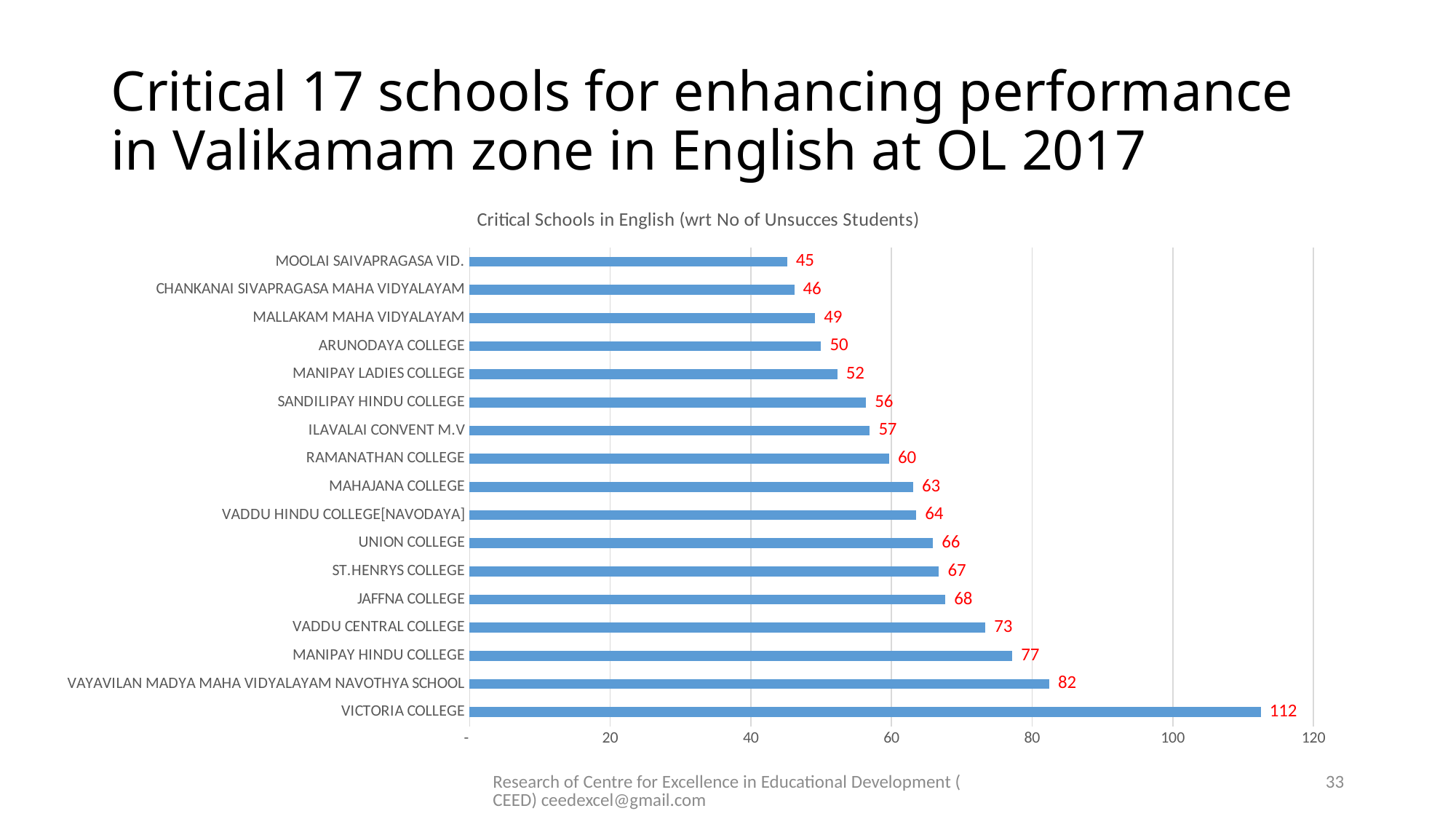
Which school has the highest number of unsuccessful students? Victoria College How many schools are shown in the chart? 17 Is the value for Vaddu Central College greater or less than 80? less What is the title of the chart? Critical Schools in English (wrt No of Unsucces Students) What is the value for Ramanathan College? 60 Which school has the lowest number of unsuccessful students? Moolai Saivapragasa Vid. What colour are the bars in the chart? Blue What is the value for Victoria College? 112 What kind of chart is shown on the slide? Bar chart Which has a larger value, Jaffna College or Union College? Jaffna College What is the difference between the values for Victoria College and Vayavilan Madya Maha Vidyalayam Navothya School? 30 What is the value for Manipay Hindu College? 77